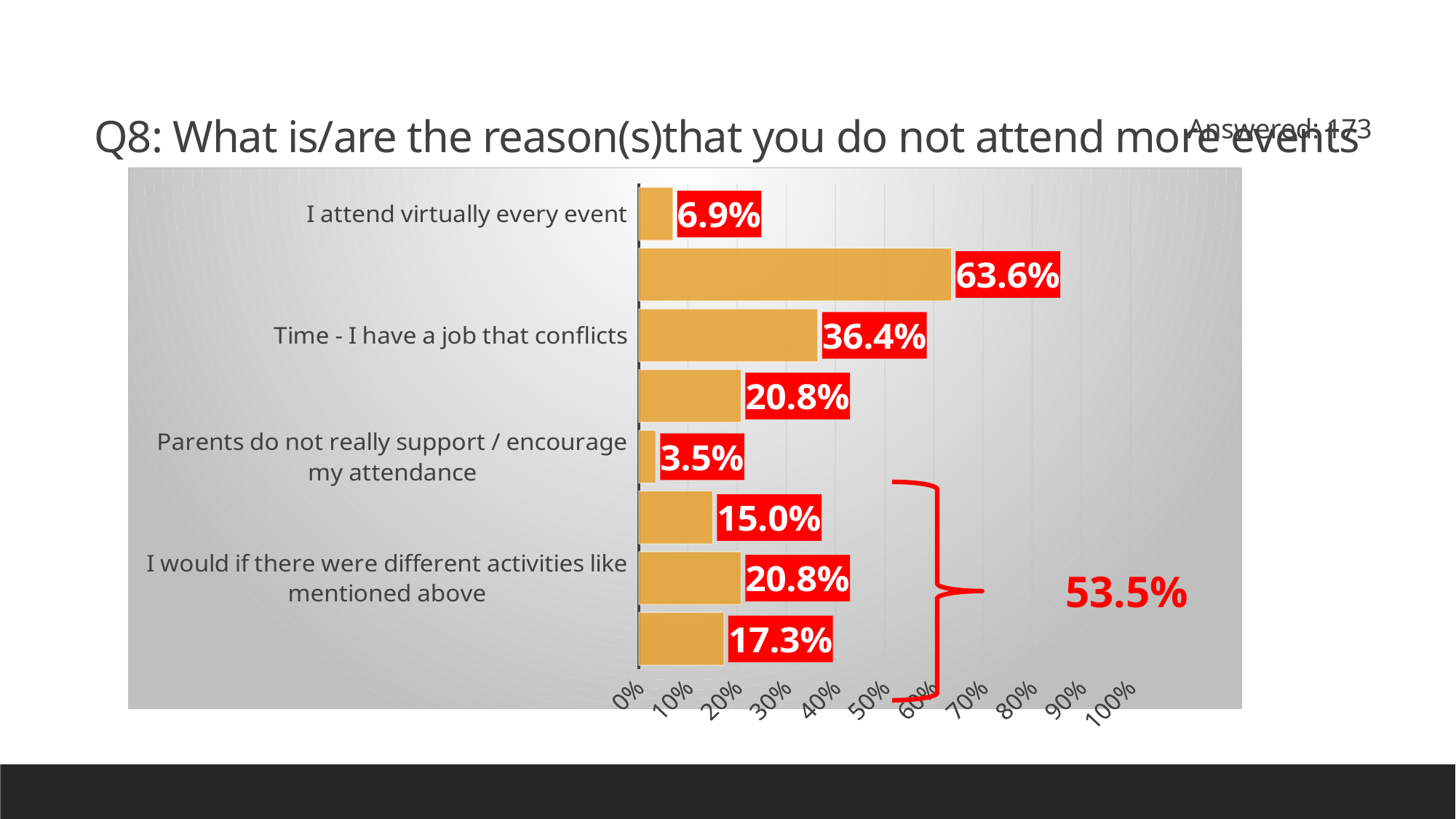
What is the value for "Time - I have a job that conflicts"? 36.4% What is the value for "I would if there were different activities like mentioned above"? 20.8% What percentage is shown next to the red bracket grouping the bottom three bars? 53.5% What kind of chart is shown on the slide? bar chart What is the value for "I attend virtually every event"? 6.9% Is the value for "Time - I have a job that conflicts" greater or less than 30%? greater How many bars are plotted in the chart? 8 What is the difference between the values for "Time - I have a job that conflicts" and "I attend virtually every event"? 29.5% What is the value for "Parents do not really support / encourage my attendance"? 3.5% Which category has the lowest value? Parents do not really support / encourage my attendance Which is larger: the value for "Time - I have a job that conflicts" or for "I would if there were different activities like mentioned above"? Time - I have a job that conflicts What is the difference between the values for "I would if there were different activities like mentioned above" and "Parents do not really support / encourage my attendance"? 17.3%